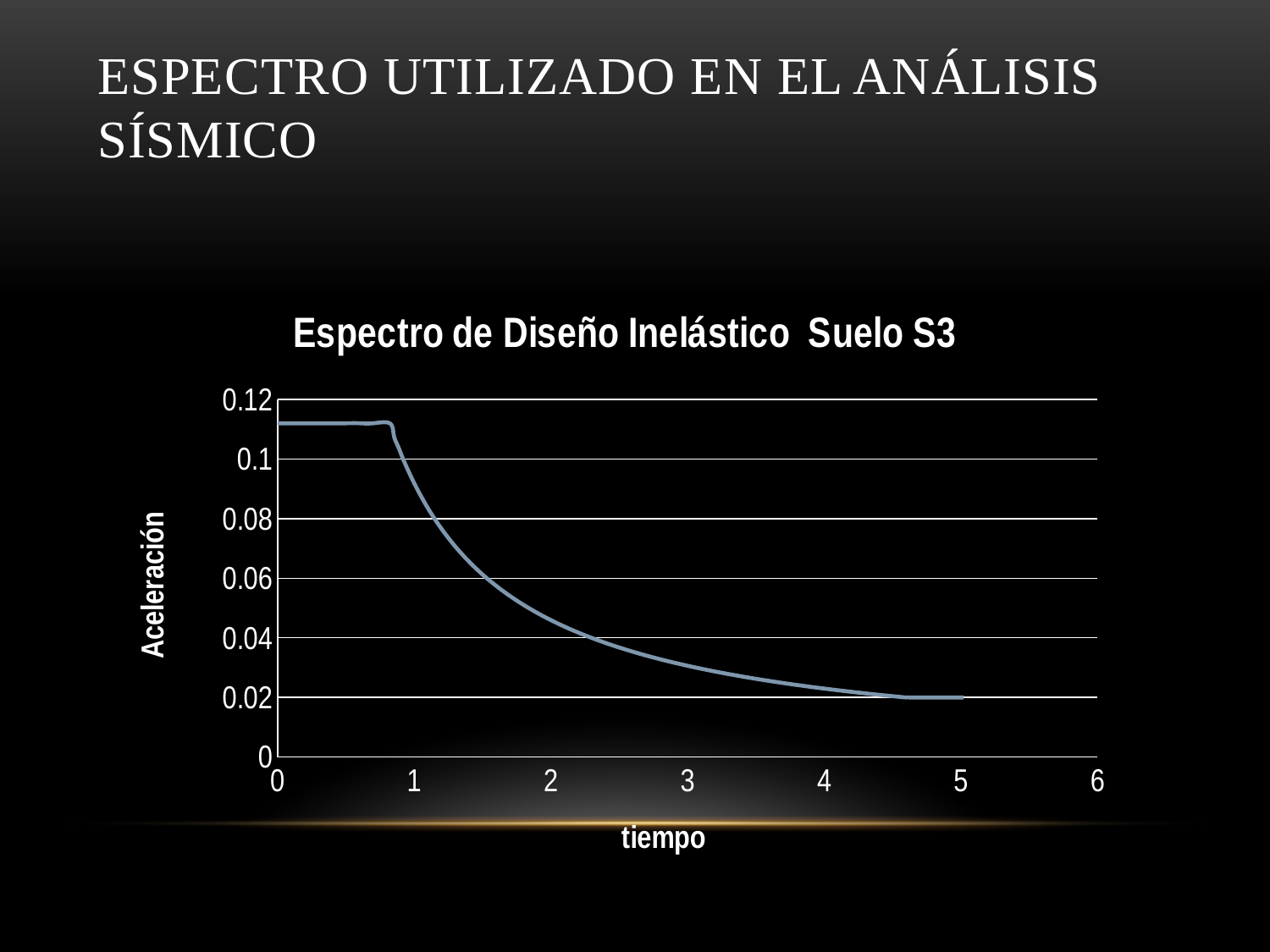
What is the title of the chart? Espectro de Diseño Inelástico Suelo S3 What is the label of the vertical axis of the chart? Aceleración Is the value of Aceleración at tiempo 4 greater or less than 0.04? less Is the value of Aceleración at tiempo 2 greater or less than 0.06? less Which is larger, the Aceleración at tiempo 1 or at tiempo 3? tiempo 1 Does the plotted value rise or fall as tiempo increases from 1 to 5? fall Is the value of Aceleración at tiempo 0.5 greater or less than 0.1? greater What is the highest value shown on the vertical axis of the chart? 0.12 What kind of chart is shown on the slide? line chart